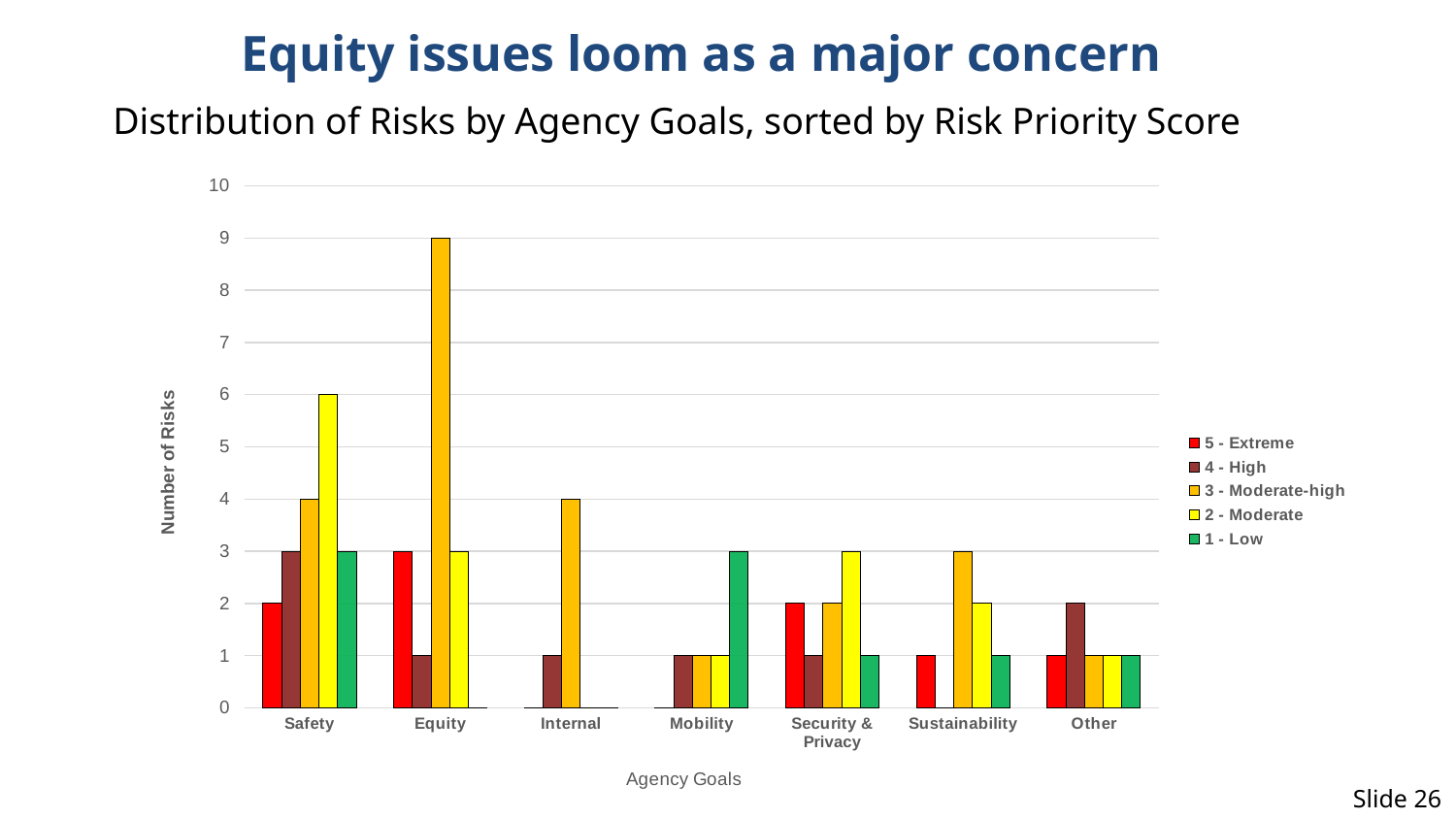
What is the difference between the 3 - Moderate-high risks for Equity and for Safety? 5 What kind of chart is shown on the slide? bar chart How many agency goal categories are shown on the x axis? 7 Is the number of 3 - Moderate-high risks for Equity greater or less than 8? greater What is the label of the y axis? Number of Risks Which agency goal has the highest number of 3 - Moderate-high risks? Equity How many series does the legend list? 5 Which is larger: the 5 - Extreme risks for Equity or the 5 - Extreme risks for Sustainability? Equity What is the number of 3 - Moderate-high risks for Internal? 4 What is the number of 2 - Moderate risks for Safety? 6 What is the number of 3 - Moderate-high risks for Equity? 9 What is the number of 1 - Low risks for Mobility? 3